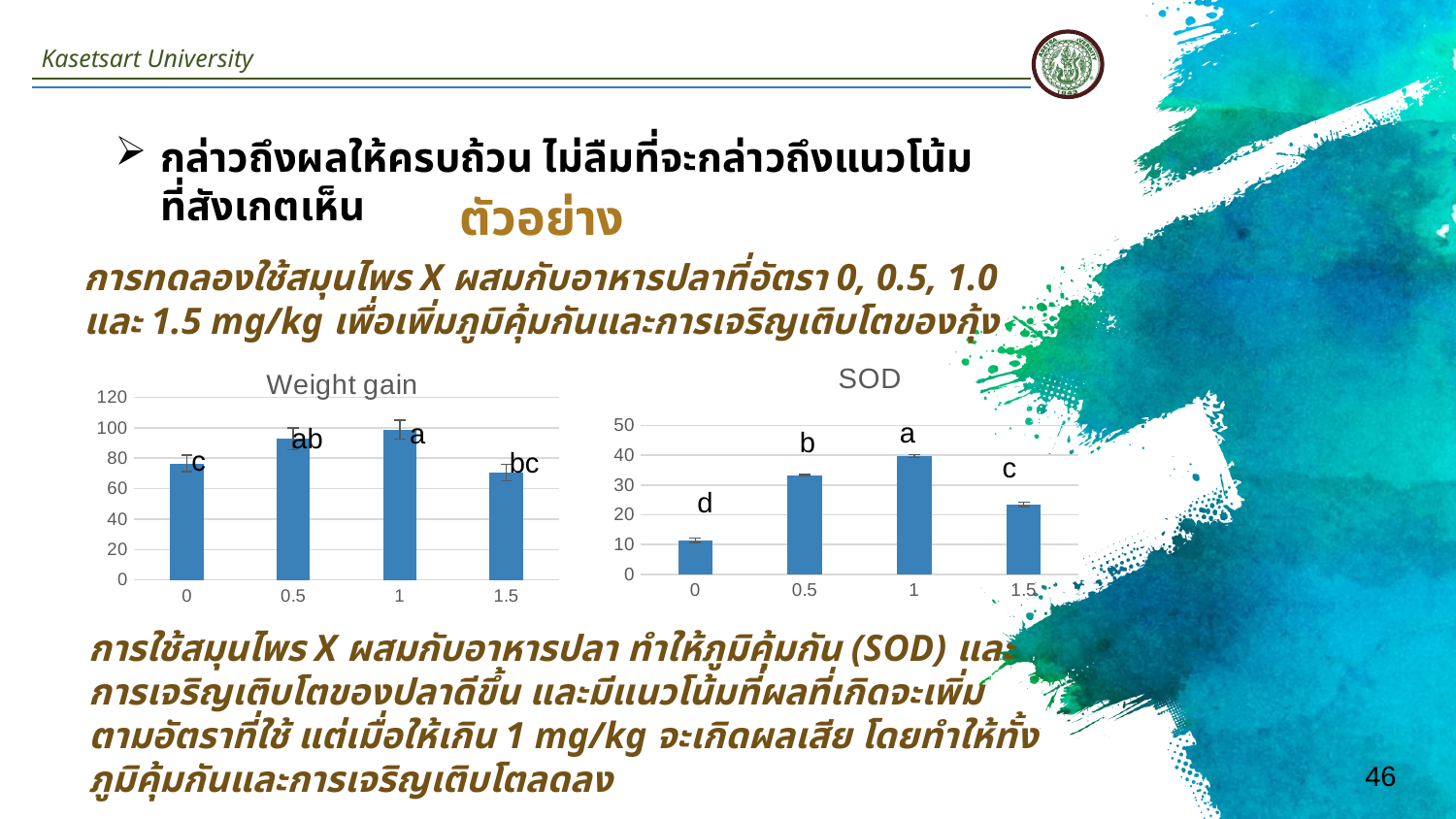
In the SOD chart, which dose has the lowest value? 0 In the SOD chart, what letter label is printed above the bar for dose 0? d What is the title of the chart on the left side of the slide? Weight gain In the SOD chart, is the value for dose 0 greater or less than 20? less In the SOD chart, is the value for dose 1.5 greater or less than 30? less In the Weight gain chart, is the value for dose 0 greater or less than 60? greater In the SOD chart, which dose has the highest value? 1 In the Weight gain chart, which is larger, the value for dose 1 or the value for dose 1.5? 1 What type of chart is the Weight gain chart? bar chart In the SOD chart, which is larger, the value for dose 0.5 or the value for dose 1.5? 0.5 How many categories (dose levels) are shown on the x axis of the SOD chart? 4